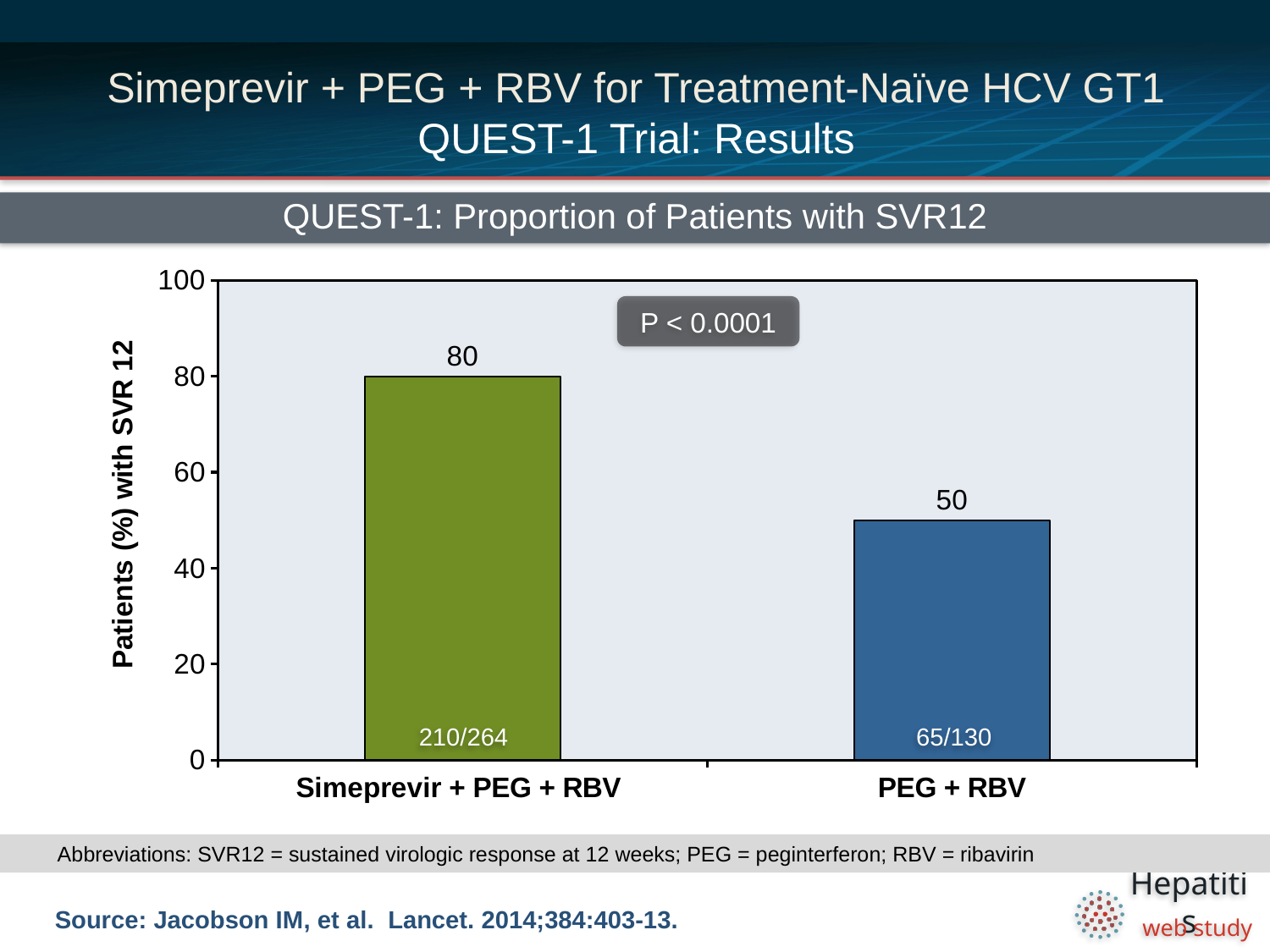
Is the value for PEG + RBV greater or less than 60? less What is the y-axis label of the chart? Patients (%) with SVR 12 What is the difference between the values for Simeprevir + PEG + RBV and PEG + RBV? 30 What is the value for PEG + RBV? 50 Which category has the lowest value? PEG + RBV What kind of chart is shown? bar chart How many categories are shown on the chart? 2 Which is larger, the value for Simeprevir + PEG + RBV or the value for PEG + RBV? Simeprevir + PEG + RBV Which category has the highest value? Simeprevir + PEG + RBV What is the value for Simeprevir + PEG + RBV? 80 What fraction of patients is printed inside the Simeprevir + PEG + RBV bar? 210/264 What is the title of the chart? QUEST-1: Proportion of Patients with SVR12